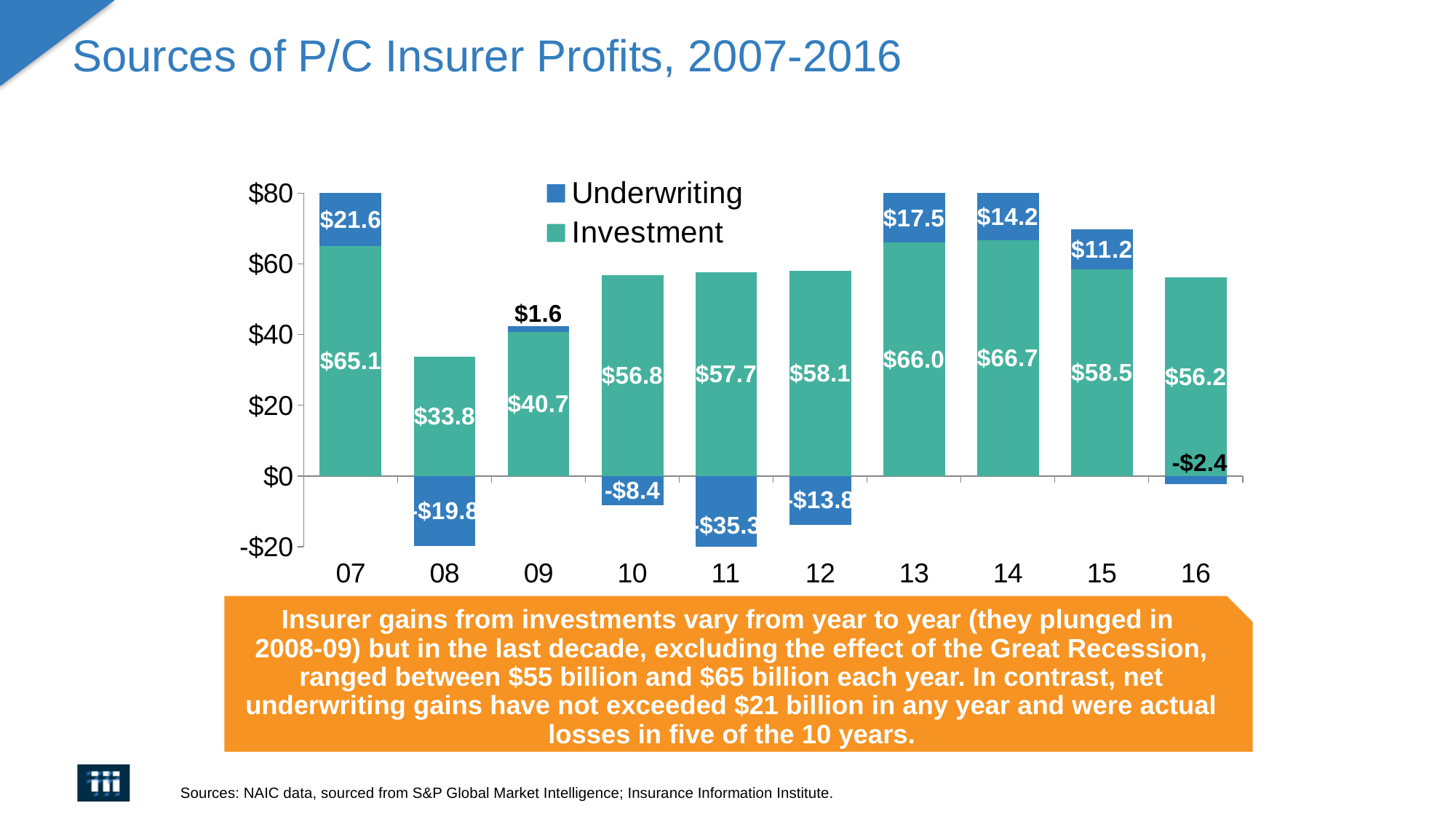
Which year has the lowest Investment value? 08 Which is larger, the Investment value for 2013 (13) or for 2015 (15)? 2013 (13) What is the Investment value for 2007 (07)? $65.1 How many years are shown on the x axis? 10 What is the total of the Underwriting and Investment values for 2007 (07)? $86.7 What is the difference between the Investment values for 2007 (07) and 2008 (08)? $31.3 What is the Underwriting value for 2016 (16)? -$2.4 Which year has the highest Investment value? 14 Which year has the highest Underwriting value? 07 What kind of chart is shown on the slide? Stacked bar chart What is the Underwriting value for 2011 (11)? -$35.3 How many series does the legend list? 2